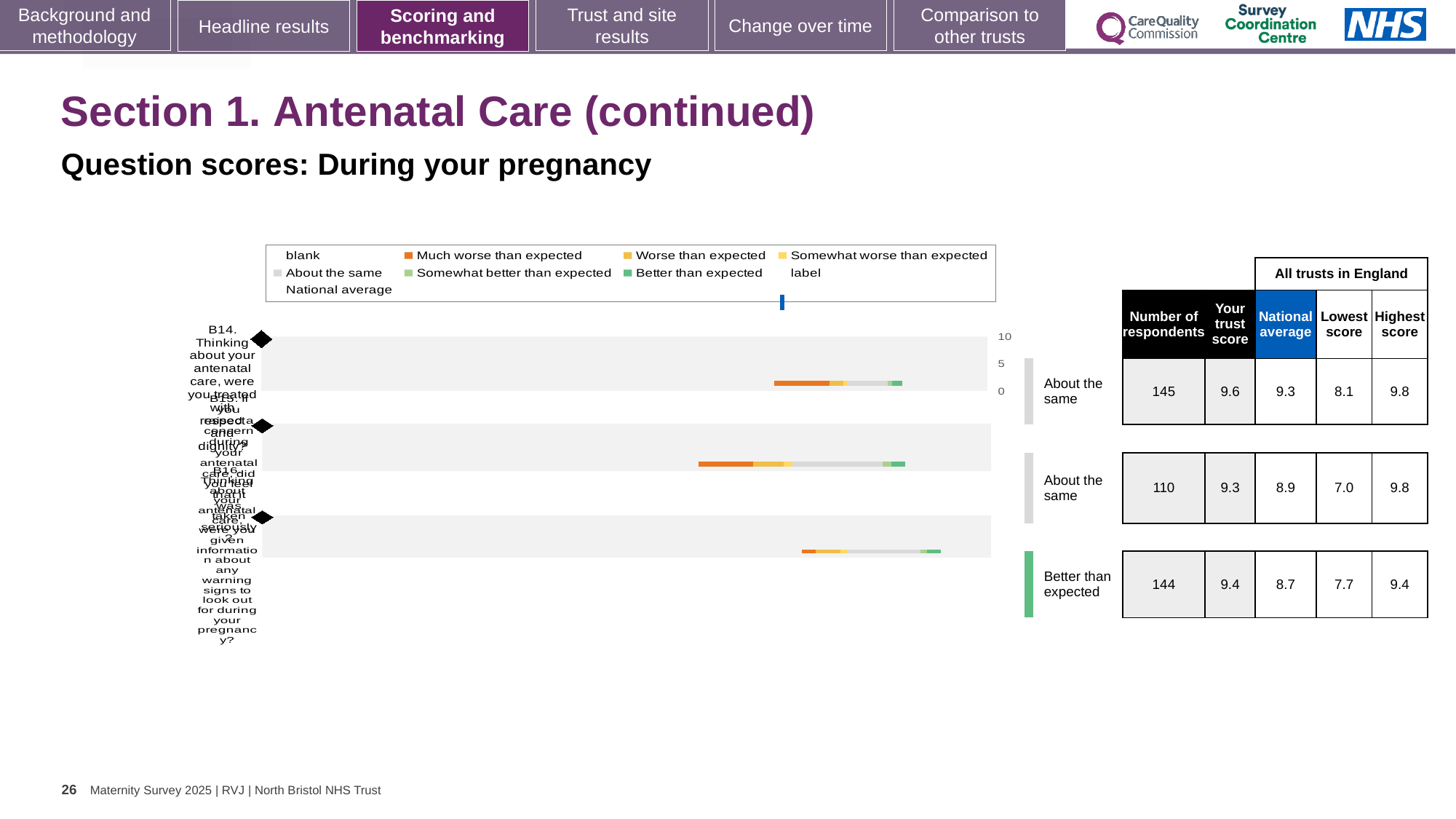
How many question rows (bars) does the chart show? 3 What kind of chart is shown on the slide? bar chart In the table beside the chart, what is the number of respondents for the first row (B14)? 145 Which row has the highest trust score in the table beside the chart? the first row (B14), 9.6 What is the subtitle describing the chart's question scores? Question scores: During your pregnancy For the second row (B15), which is larger: the trust score or the national average? the trust score (9.3) What is the lowest score across all trusts in England for the second row (B15)? 7.0 For the third row (B16), what is the difference between the trust score and the national average? 0.7 What benchmark category is given for the third row (B16)? Better than expected Which legend entry is shown in orange? Much worse than expected In the table beside the chart, what is the national average for the third row (B16)? 8.7 In the table beside the chart, what is the trust score for the first row (B14)? 9.6